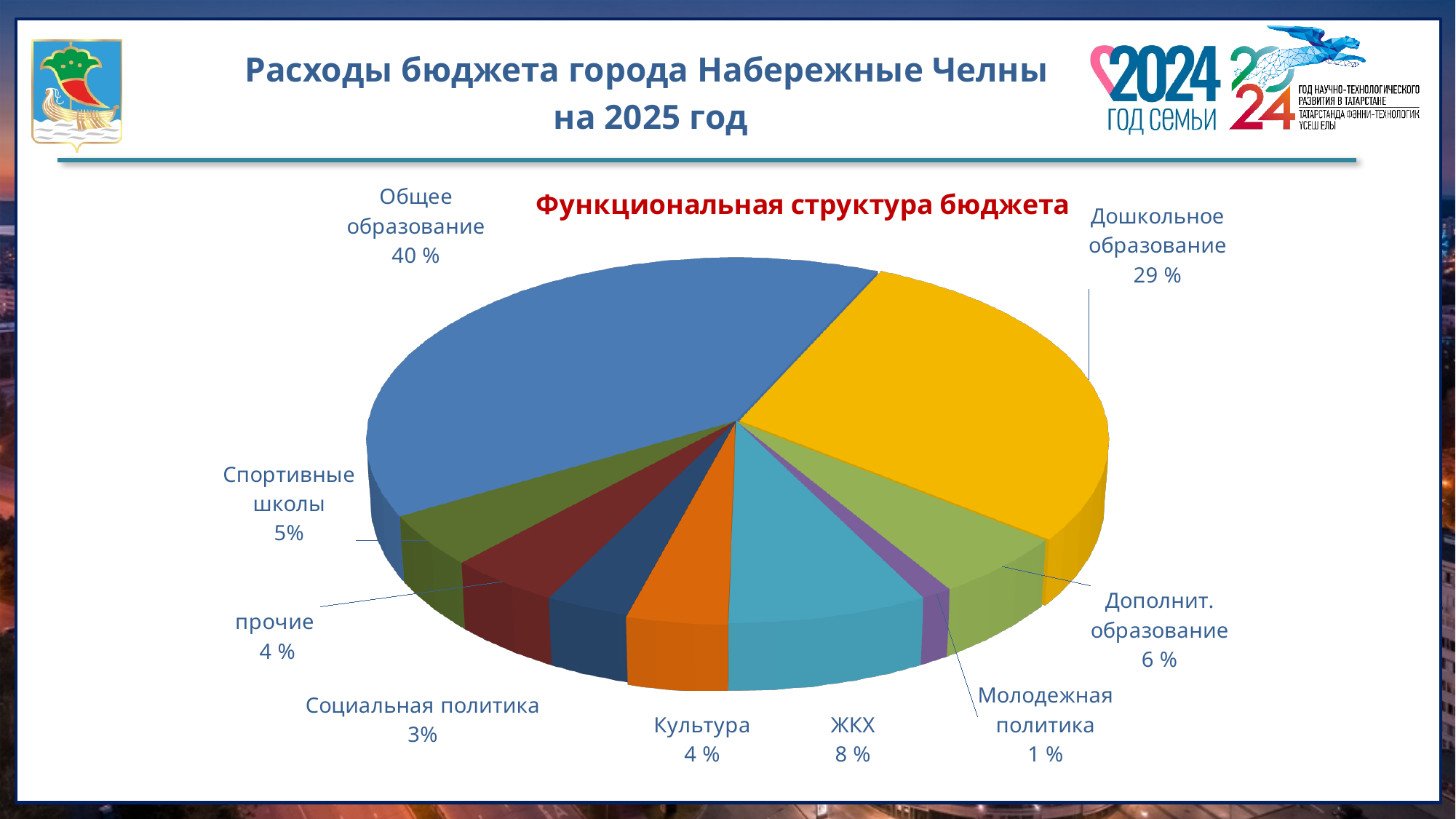
Which is larger, the share for Спортивные школы or the share for Социальная политика? Спортивные школы What is the title of the chart? Функциональная структура бюджета What kind of chart is shown on the slide? pie chart How many categories are shown in the pie chart? 9 Which category has the smallest share of the budget? Молодежная политика What is the difference in percentage points between Общее образование and Дошкольное образование? 11 What share of the budget goes to Молодежная политика? 1 % What is the combined share of Дополнит. образование and Культура? 10 % What share of the budget goes to Дошкольное образование? 29 % What share of the budget goes to ЖКХ? 8 % Which category has the largest share of the budget? Общее образование What share of the budget goes to Общее образование? 40 %